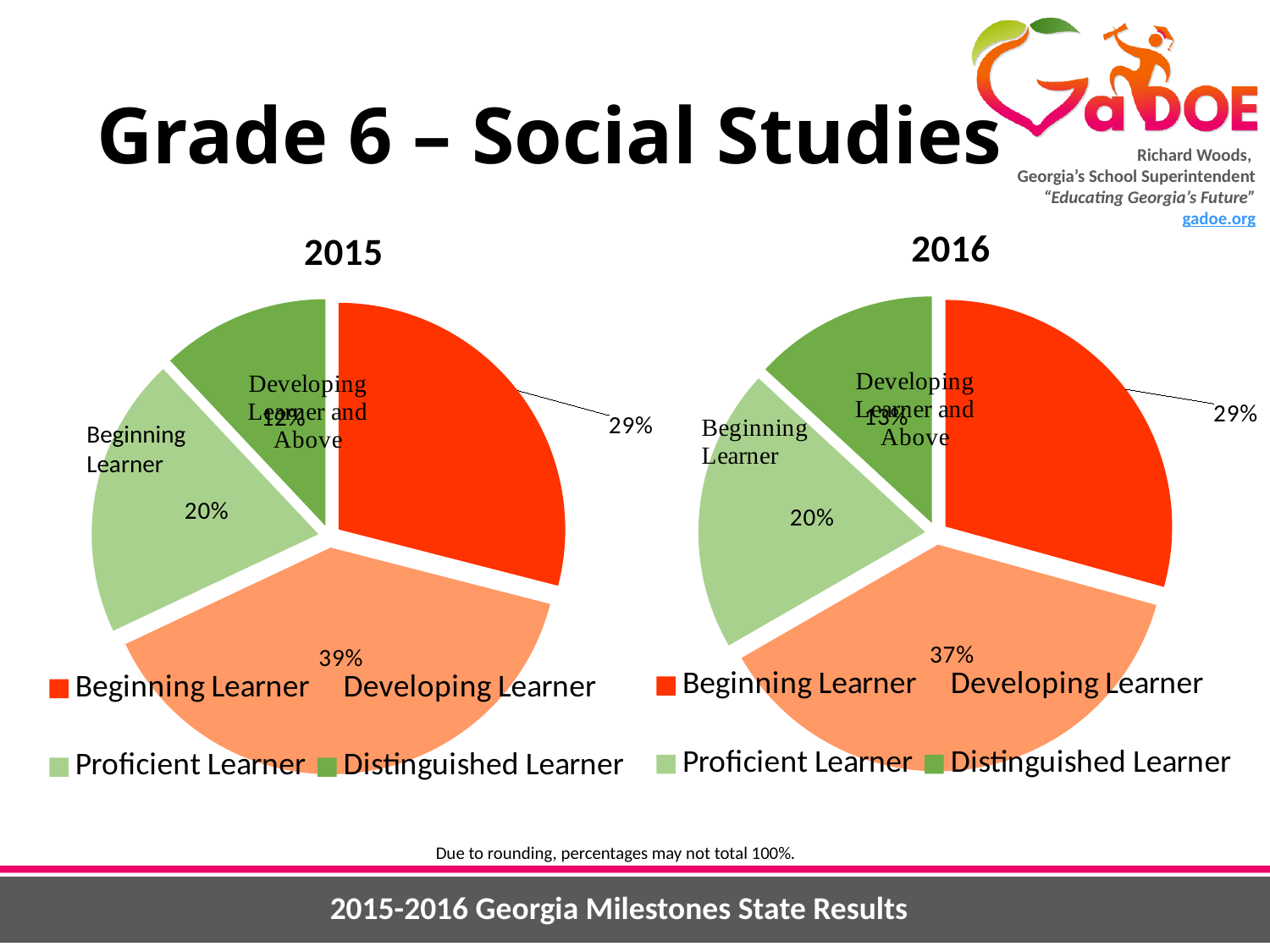
In the 2015 chart, which category has the largest slice? Developing Learner In the 2016 chart, what percentage is shown for Developing Learner? 37% In the 2016 chart, which category has the smallest slice? Distinguished Learner In the 2016 chart, what percentage is shown for Distinguished Learner? 13% What colour represents Beginning Learner in the legends? red How many slices does the 2016 pie chart have? 4 What is the difference between the Developing Learner percentage in 2015 and in 2016? 2% What type of chart is used to show the 2015 results? pie chart In the 2015 chart, what percentage is shown for Distinguished Learner? 12% In the 2015 chart, what percentage is shown for Developing Learner? 39% In the 2016 chart, what is the combined percentage of Proficient Learner and Distinguished Learner? 33% In the 2015 chart, is the Beginning Learner slice larger or smaller than the Proficient Learner slice? larger